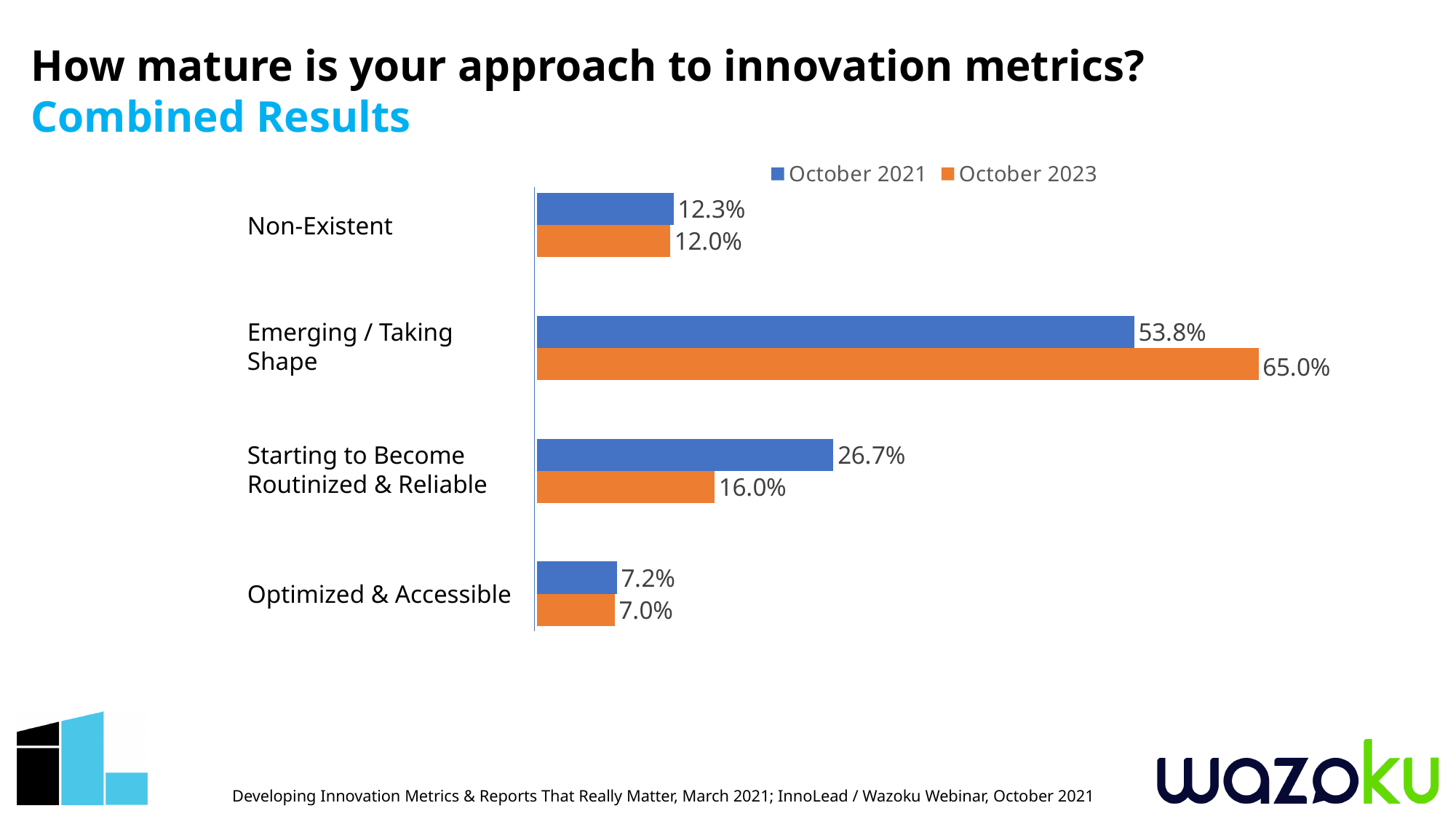
How many series does the legend list? 2 Which category has the highest October 2023 value? Emerging / Taking Shape What is the October 2021 value for Optimized & Accessible? 7.2% For Starting to Become Routinized & Reliable, which is larger: the October 2021 value or the October 2023 value? October 2021 How many categories are shown on the chart? 4 What is the difference between the October 2023 and October 2021 values for Emerging / Taking Shape? 11.2% What is the October 2023 value for Starting to Become Routinized & Reliable? 16.0% What kind of chart is shown on the slide? Bar chart What is the October 2021 value for Emerging / Taking Shape? 53.8% What is the difference between the October 2021 and October 2023 values for Starting to Become Routinized & Reliable? 10.7% What is the October 2023 value for Non-Existent? 12.0% Which category has the lowest October 2021 value? Optimized & Accessible